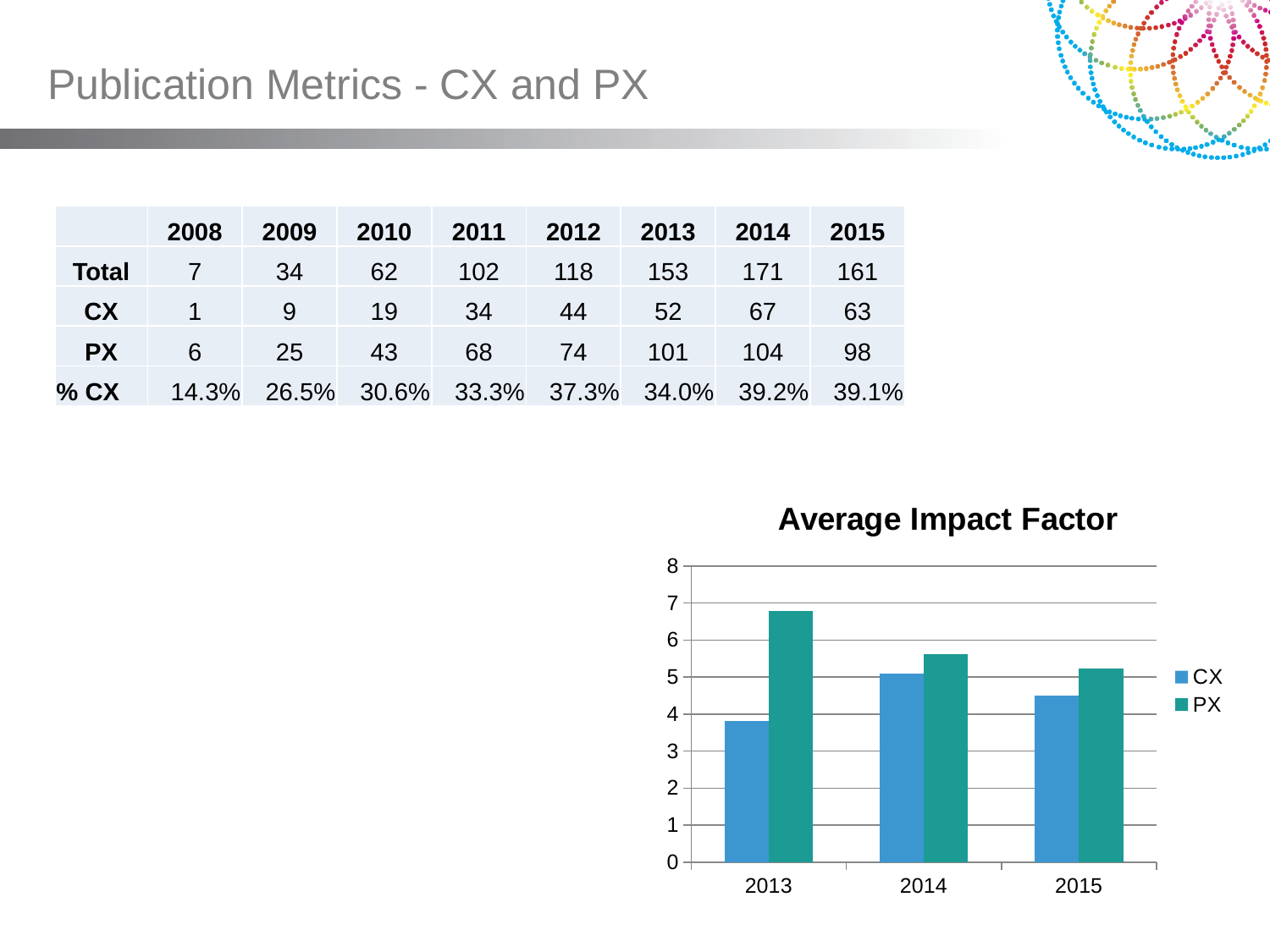
In the Average Impact Factor chart, is the PX value for 2013 greater or less than 6? greater What is the title of the chart on the slide? Average Impact Factor How many years are shown on the x axis of the Average Impact Factor chart? 3 In the Average Impact Factor chart, do the PX values rise or fall from 2013 to 2015? fall In the Average Impact Factor chart, which year has the highest PX value? 2013 In the Average Impact Factor chart, which series is shown in blue? CX In the Average Impact Factor chart, which year has the lowest CX value? 2013 What kind of chart is the Average Impact Factor chart? bar chart How many series does the legend of the Average Impact Factor chart list? 2 In the Average Impact Factor chart, which series has the larger value in 2013, CX or PX? PX In the Average Impact Factor chart, is the CX value for 2015 greater or less than 5? less In the Average Impact Factor chart, is the CX value for 2013 greater or less than 4? less